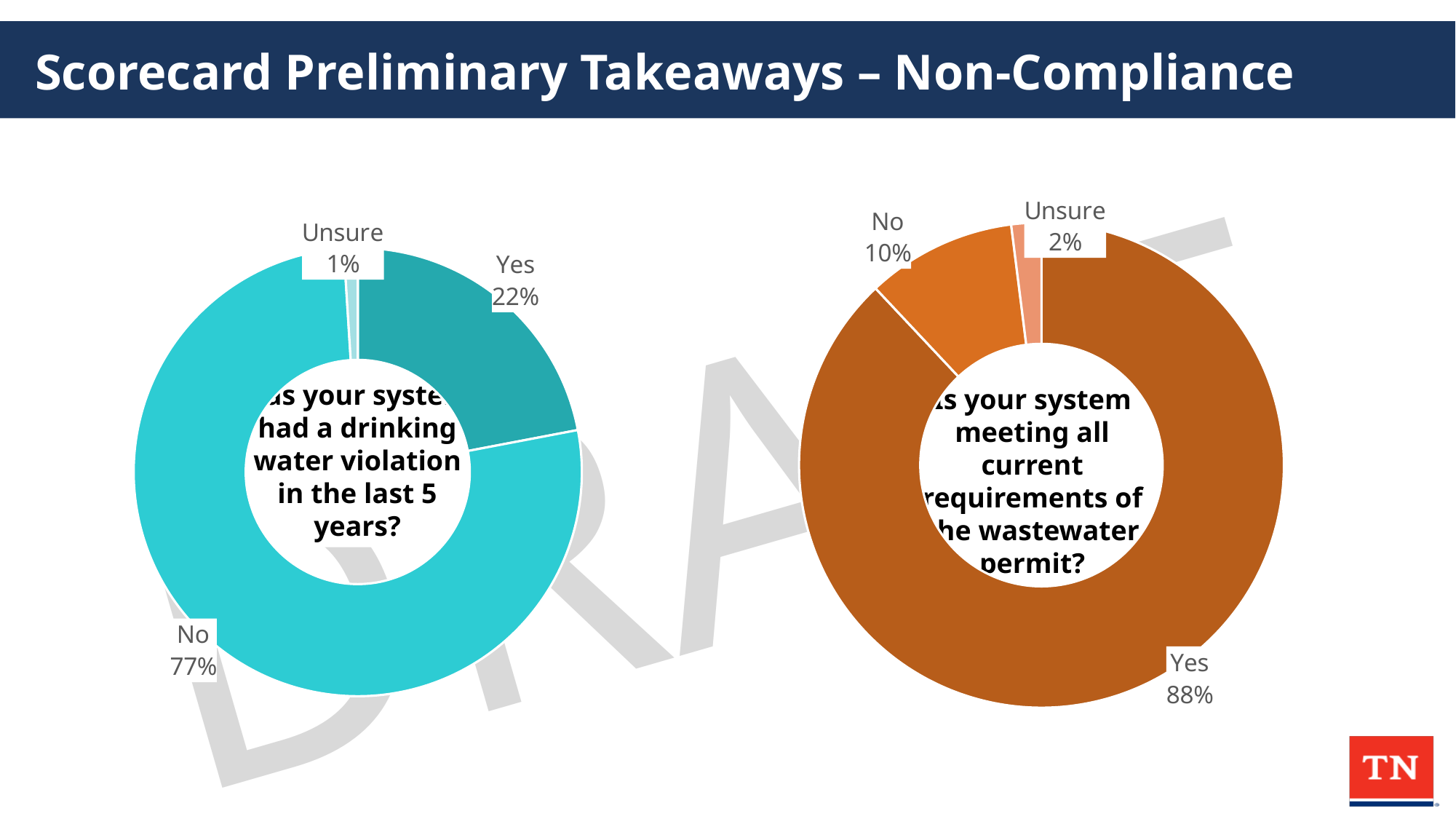
In the right chart (wastewater permit), what share of respondents answered No? 10% In the right chart (wastewater permit), which response has the smallest share? Unsure In the right chart (wastewater permit), what share of respondents answered Yes? 88% In the left chart (drinking water violation), what share of respondents answered No? 77% In the left chart (drinking water violation), what share of respondents answered Yes? 22% In the right chart (wastewater permit), what share of respondents answered Unsure? 2% In the left chart (drinking water violation), what share of respondents answered Unsure? 1% In the left chart (drinking water violation), what is the difference in percentage points between the No and Yes shares? 55 In the right chart (wastewater permit), which is larger, the No share or the Unsure share? No What kind of chart is the left chart (drinking water violation)? Pie (donut) chart How many slices does the right chart (wastewater permit) have? 3 In the left chart (drinking water violation), which response has the largest share? No